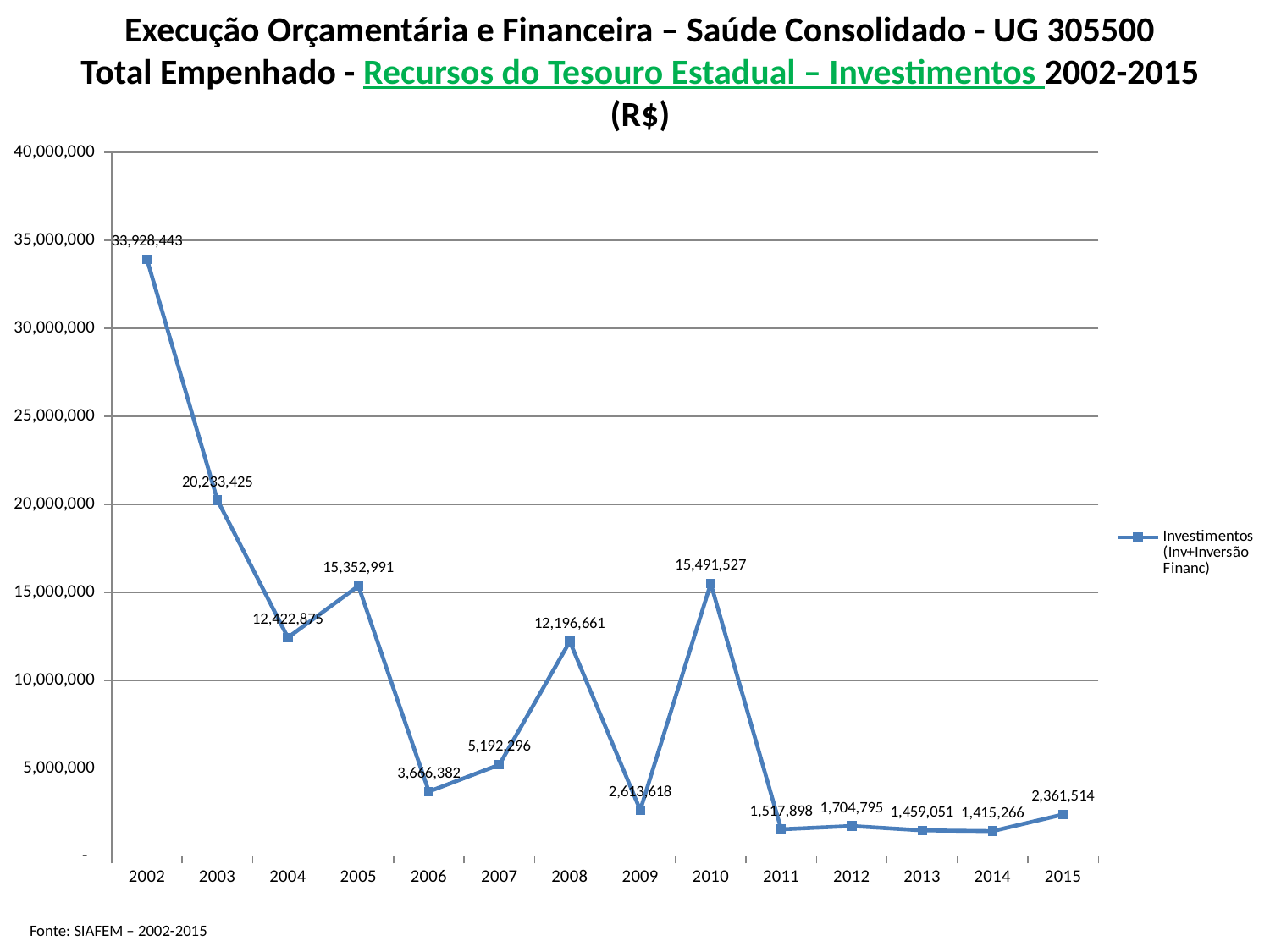
What is the value for 2008? 12,196,661 What is the difference between the values for 2010 and 2005? 138,536 Do the values rise or fall from 2002 to 2004? fall What kind of chart is shown? line chart Which year has the lowest value? 2014 What is the value for 2010? 15,491,527 Is the value for 2002 greater or less than 30,000,000? greater What is the value for 2002? 33,928,443 What is the value for 2015? 2,361,514 Which year has the highest value? 2002 Which is larger, the value for 2007 or the value for 2008? 2008 How many years are plotted on the chart? 14